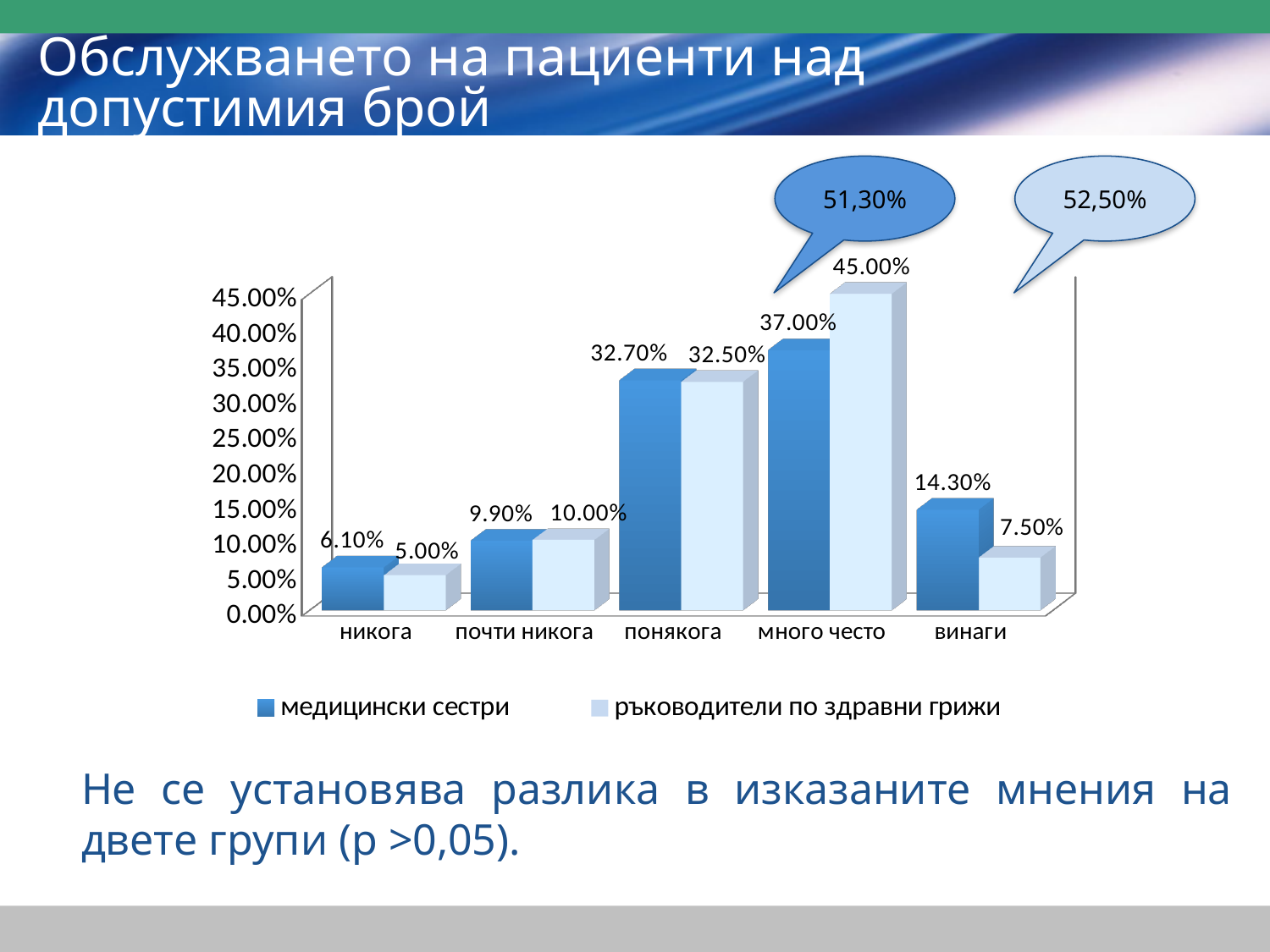
What is the value for ръководители по здравни грижи in the много често category? 45.00% What is the value for медицински сестри in the много често category? 37.00% What is the value for ръководители по здравни грижи in the никога category? 5.00% What is the difference between the медицински сестри and ръководители по здравни грижи values in the винаги category? 6.80% What kind of chart is shown on the slide? bar chart What is the value for медицински сестри in the винаги category? 14.30% How many categories are shown on the x axis? 5 In the много често category, which series has the larger value: медицински сестри or ръководители по здравни грижи? ръководители по здравни грижи Which category has the lowest value for медицински сестри? никога How many series does the legend list? 2 What value is shown in the darker blue callout above the chart? 51,30% Which category has the highest value for ръководители по здравни грижи? много често